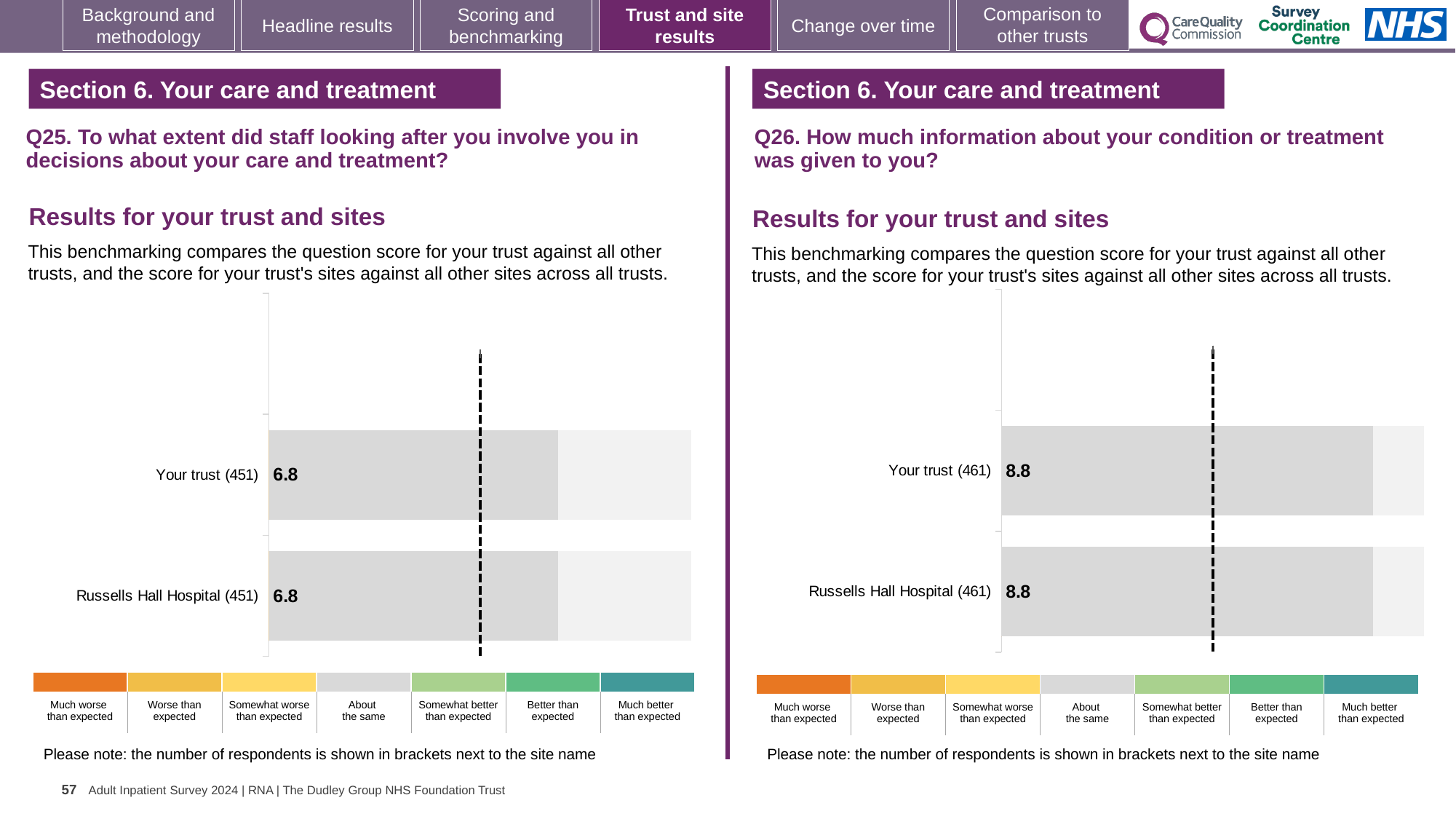
In the Q26 chart on the right, how many respondents are shown in brackets next to Russells Hall Hospital? 461 In the Q25 chart on the left, what is the score for Russells Hall Hospital? 6.8 In the Q25 chart on the left, how many respondents are shown in brackets next to Your trust? 451 How many bars are plotted in the Q25 chart on the left? 2 Is the score for Your trust in the Q26 chart on the right larger than the score for Your trust in the Q25 chart on the left? Yes In the Q26 chart on the right, what is the difference between the score for Your trust and the score for Russells Hall Hospital? 0 In the Q25 chart on the left, what is the score for Your trust? 6.8 In the Q25 chart on the left, what is the difference between the score for Your trust and the score for Russells Hall Hospital? 0 In the Q26 chart on the right, what is the score for Your trust? 8.8 What kind of chart is used for the Q25 results on the left? Bar chart How many bars are plotted in the Q26 chart on the right? 2 In the Q26 chart on the right, what is the score for Russells Hall Hospital? 8.8